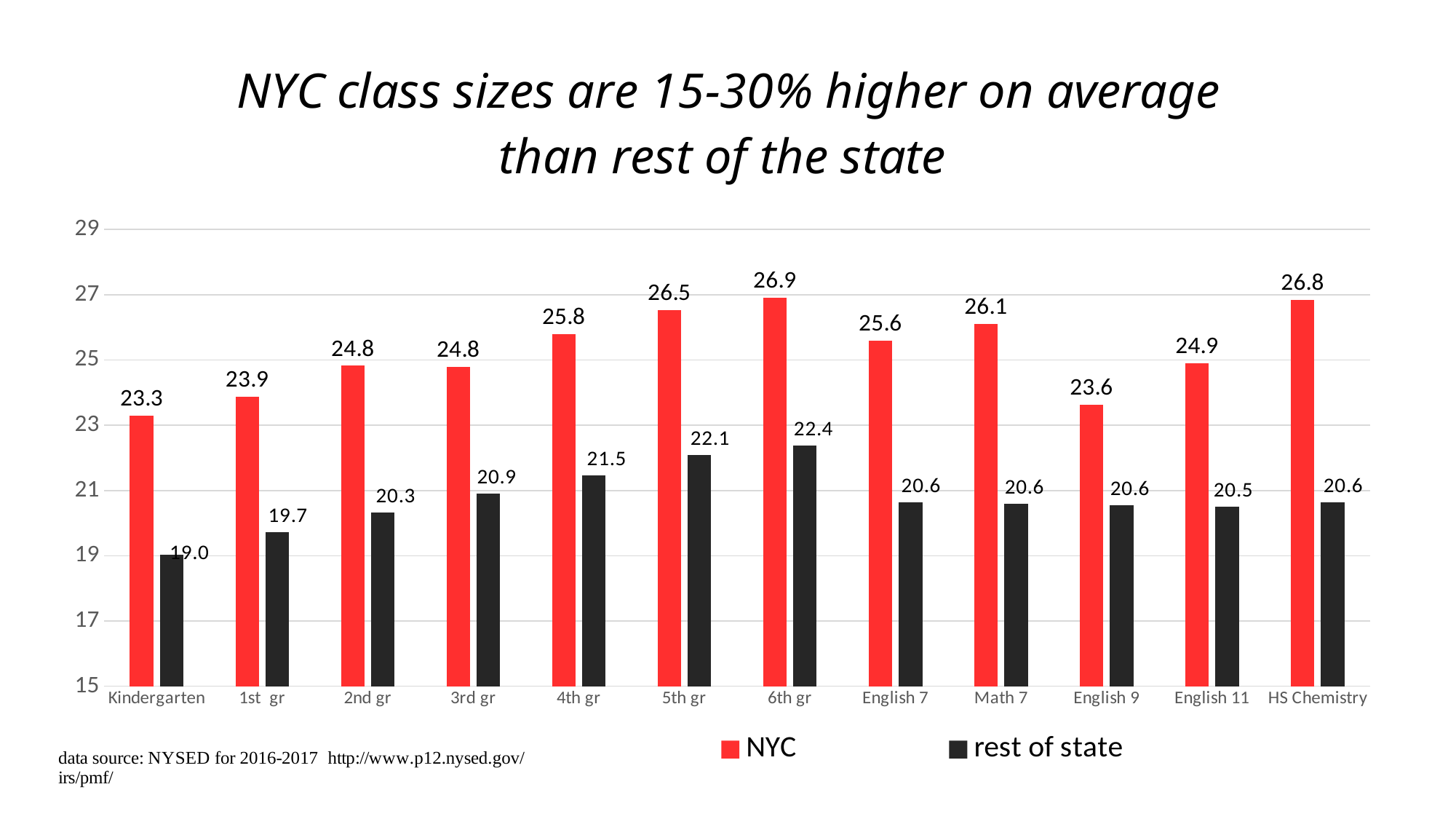
What is the rest of state class size for 3rd gr? 20.9 What is the difference between the NYC and rest of state class sizes for 4th gr? 4.3 How many categories are shown on the x axis? 12 How many series does the legend list? 2 What kind of chart is shown on the slide? bar chart What is the NYC class size for 6th gr? 26.9 What is the rest of state class size for Kindergarten? 19.0 Which category has the lowest rest of state class size? Kindergarten What is the NYC class size for English 9? 23.6 What colour are the NYC bars? red Which category has the highest NYC class size? 6th gr Which is larger, the NYC class size for 5th gr or for HS Chemistry? HS Chemistry